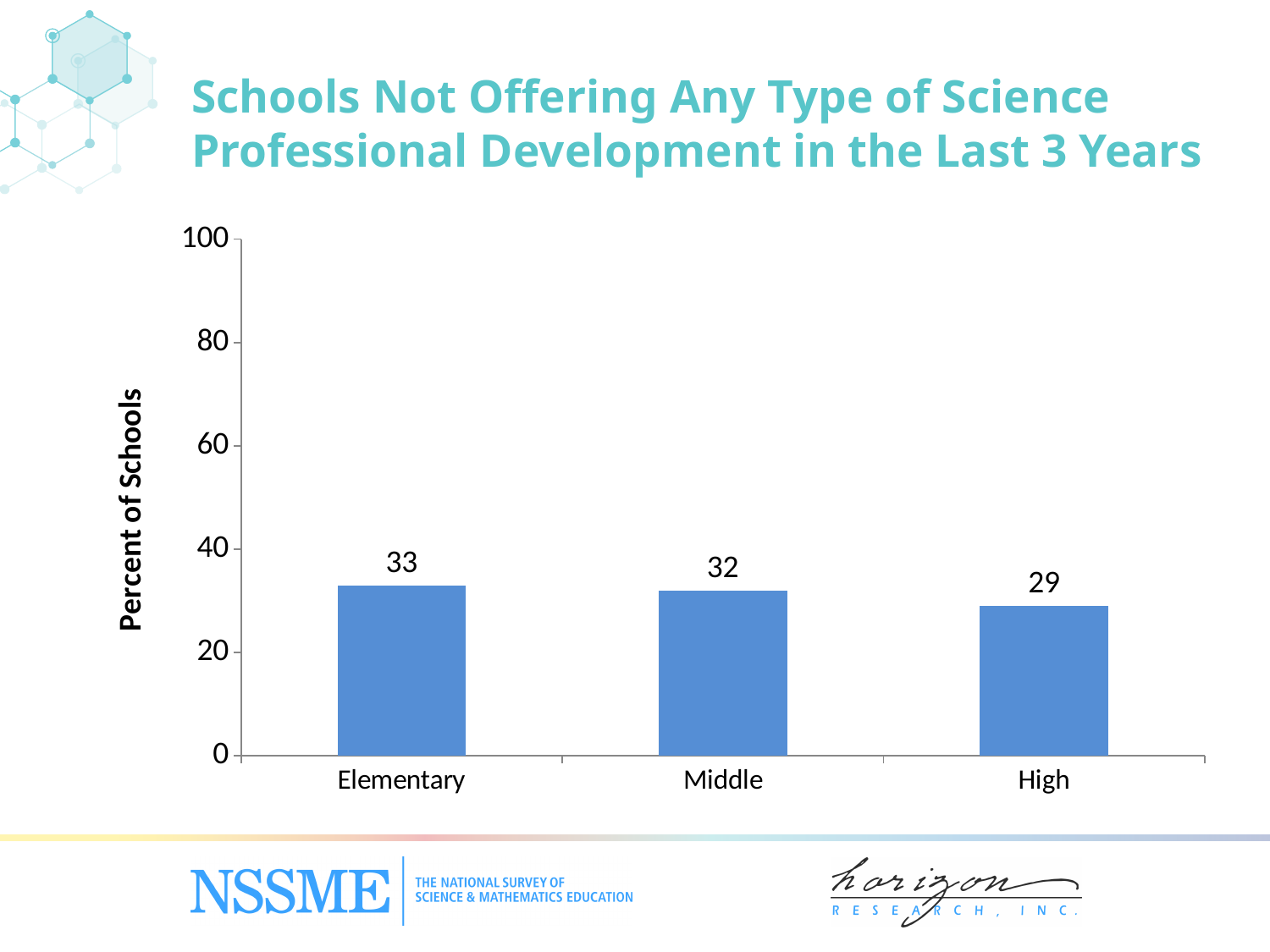
What is the value for Middle schools? 32 Which school level has the highest percent of schools not offering science professional development? Elementary What is the label of the vertical axis? Percent of Schools What is the difference between the values for Middle and High? 3 What is the value for High schools? 29 Which school level has the lowest percent of schools not offering science professional development? High How many school levels are shown on the chart? 3 Which is larger, the value for Elementary or the value for High? Elementary What is the value for Elementary schools? 33 What is the difference between the values for Elementary and High? 4 Is the value for Middle greater or less than 40? less What kind of chart is shown on the slide? bar chart